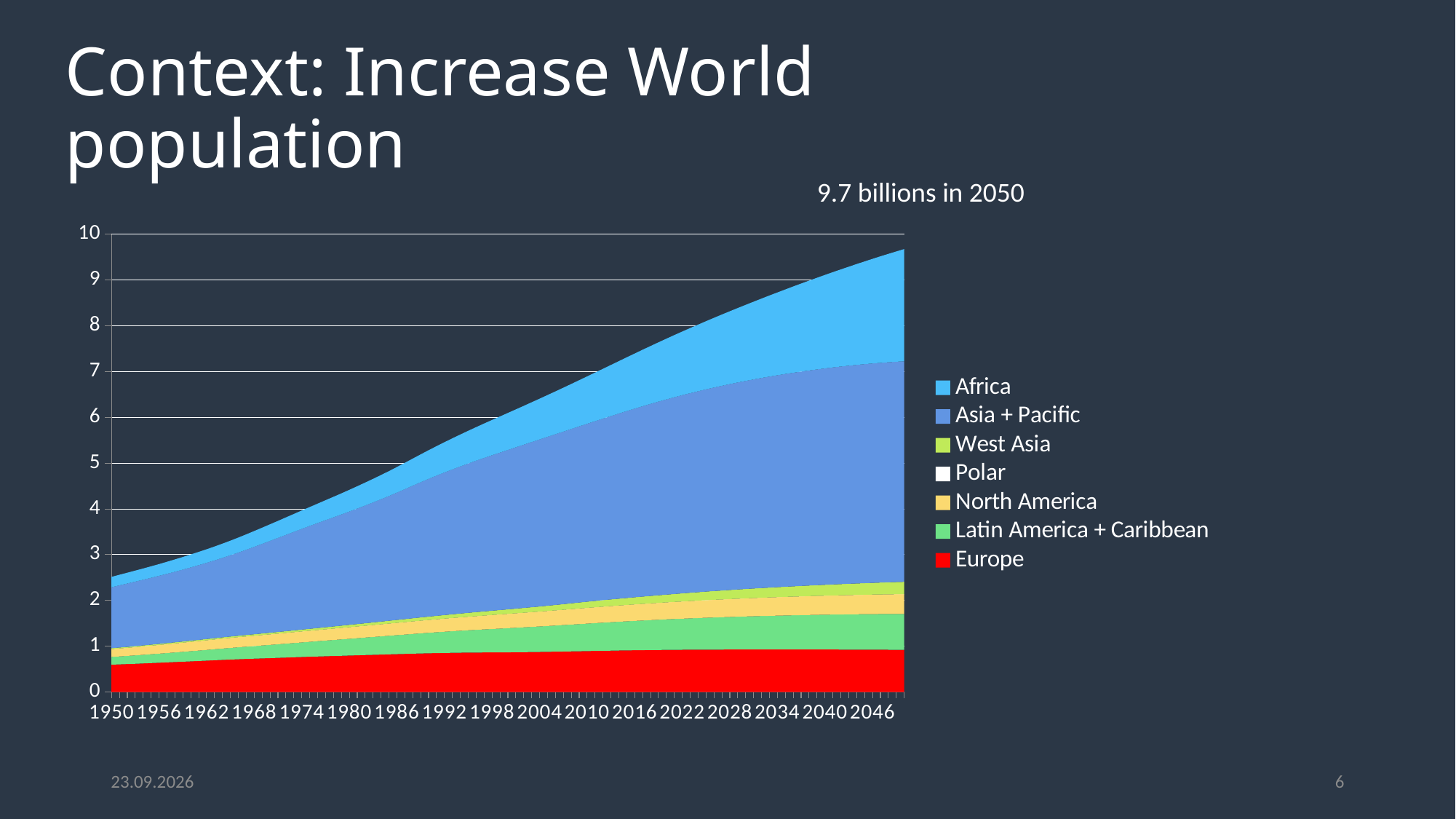
Which series is larger at the right end of the chart, Africa or Europe? Africa What is the highest value shown on the y axis? 10 What is the first year label on the x axis? 1950 Does the total world population in the chart rise or fall from 1950 to 2050? Rise How many series does the chart legend list? 7 Is the total stacked value in 1980 greater or less than 4? greater What colour represents Europe in the chart? Red Is the total stacked value at the right end of the chart (2050) greater or less than 9? greater Which series occupies the smallest area in the chart? Polar Is the total stacked value in 1950 greater or less than 3? less What kind of chart is shown on the slide? Stacked area chart Which series occupies the largest area in the chart? Asia + Pacific